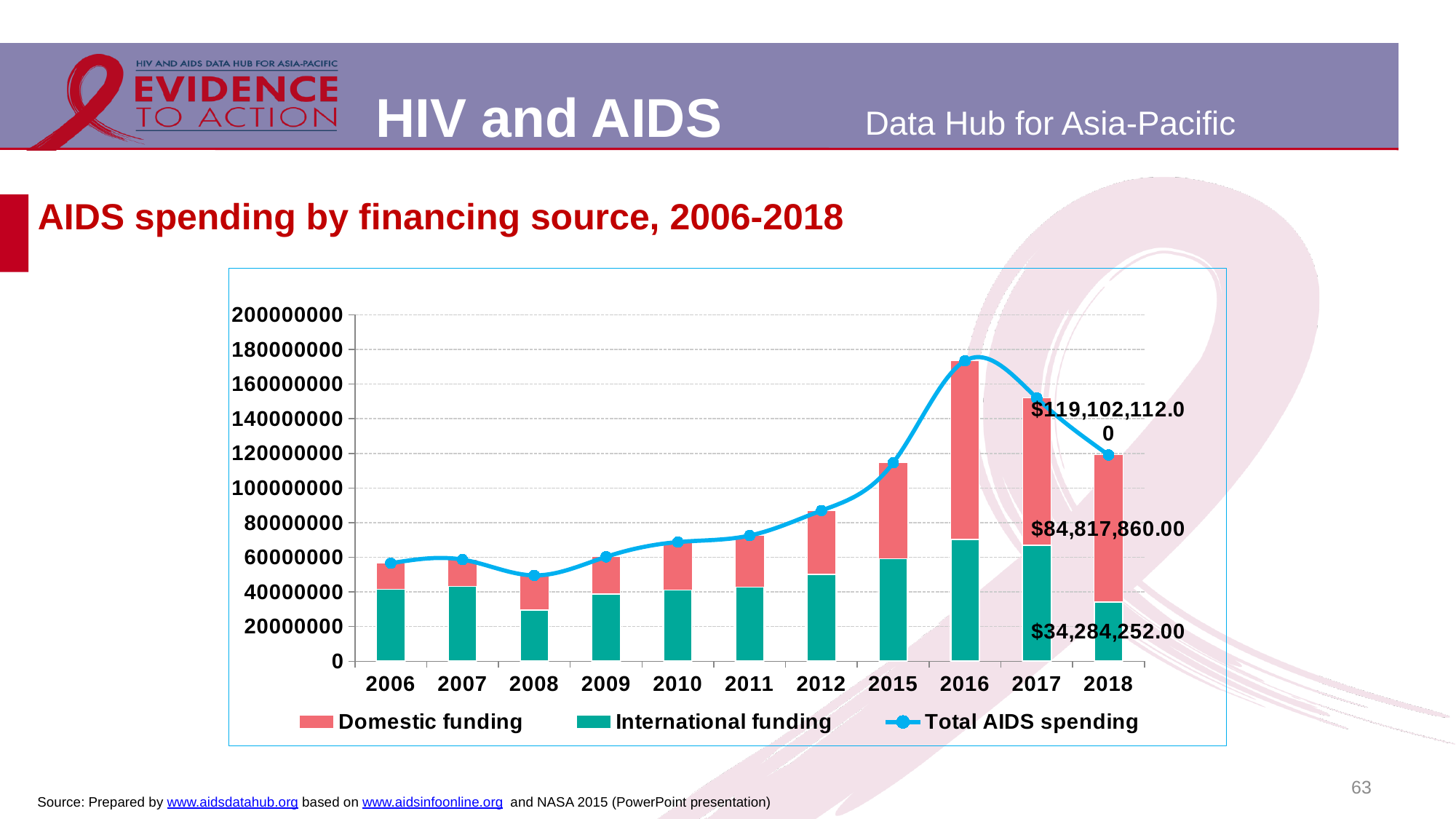
Does Total AIDS spending rise or fall from 2016 to 2018? fall How many series does the legend list? 3 How many years are shown on the x axis? 11 In which year is Total AIDS spending highest? 2016 What is the value of International funding in 2018? $34,284,252.00 Which is larger in 2018, Domestic funding or International funding? Domestic funding Is the Total AIDS spending for 2016 greater or less than 160000000? greater In which year is Total AIDS spending lowest? 2008 What is the value of Domestic funding in 2018? $84,817,860.00 What is the Total AIDS spending in 2018? $119,102,112.00 In 2018, how much larger is Domestic funding than International funding? $50,533,608.00 Is the Total AIDS spending for 2008 greater or less than 60000000? less